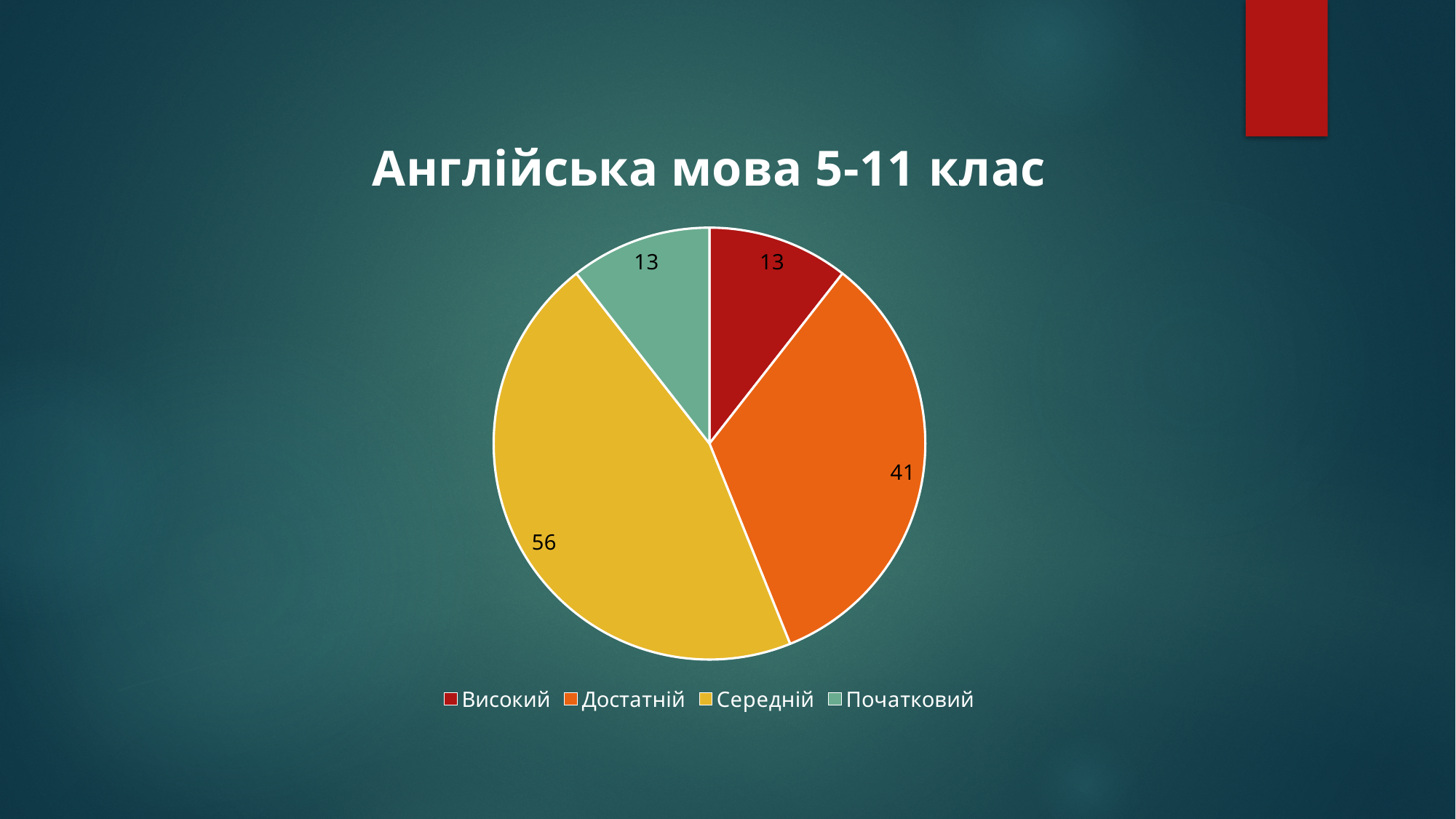
What is the difference between the values for Середній and Достатній? 15 How many categories does the pie chart have? 4 What is the value for Середній? 56 What is the value for Початковий? 13 What colour is the Середній slice? yellow Which is larger, Достатній or Середній? Середній What is the difference between the values for Достатній and Високий? 28 Which category has the largest slice? Середній What is the value for Високий? 13 What is the value for Достатній? 41 What is the title of the chart? Англійська мова 5-11 клас What type of chart is shown on the slide? pie chart